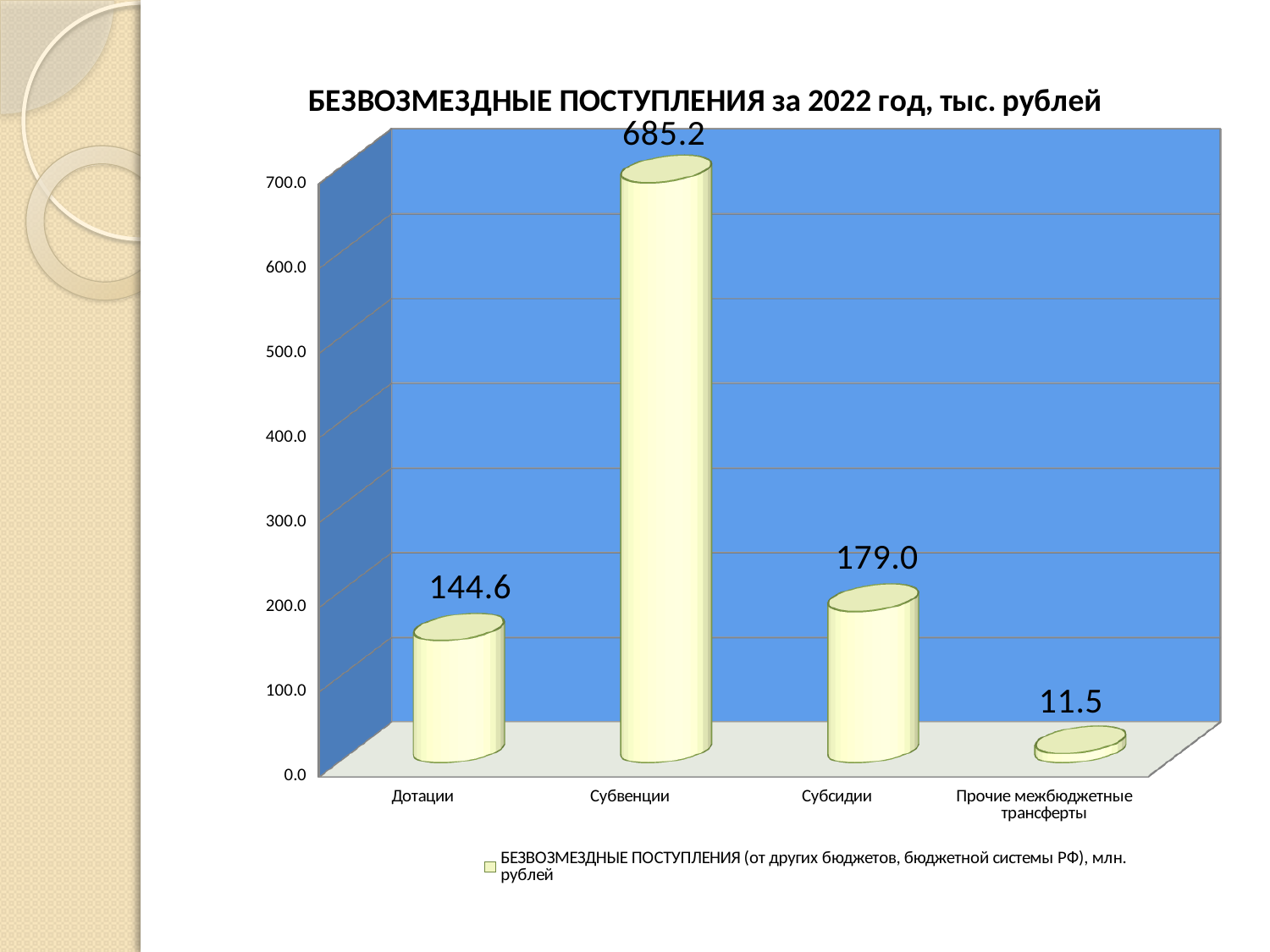
Is the value for Субвенции greater or less than 600.0? greater How many categories are shown on the x axis? 4 What is the value for Дотации? 144.6 What is the value for Субвенции? 685.2 Which category has the lowest value? Прочие межбюджетные трансферты What is the value for Прочие межбюджетные трансферты? 11.5 What kind of chart is shown on the slide? bar chart What is the value for Субсидии? 179.0 What is the difference between the values for Субсидии and Дотации? 34.4 Which category has the highest value? Субвенции Which is larger, the value for Дотации or the value for Субсидии? Субсидии What is the title of the chart? БЕЗВОЗМЕЗДНЫЕ ПОСТУПЛЕНИЯ за 2022 год, тыс. рублей